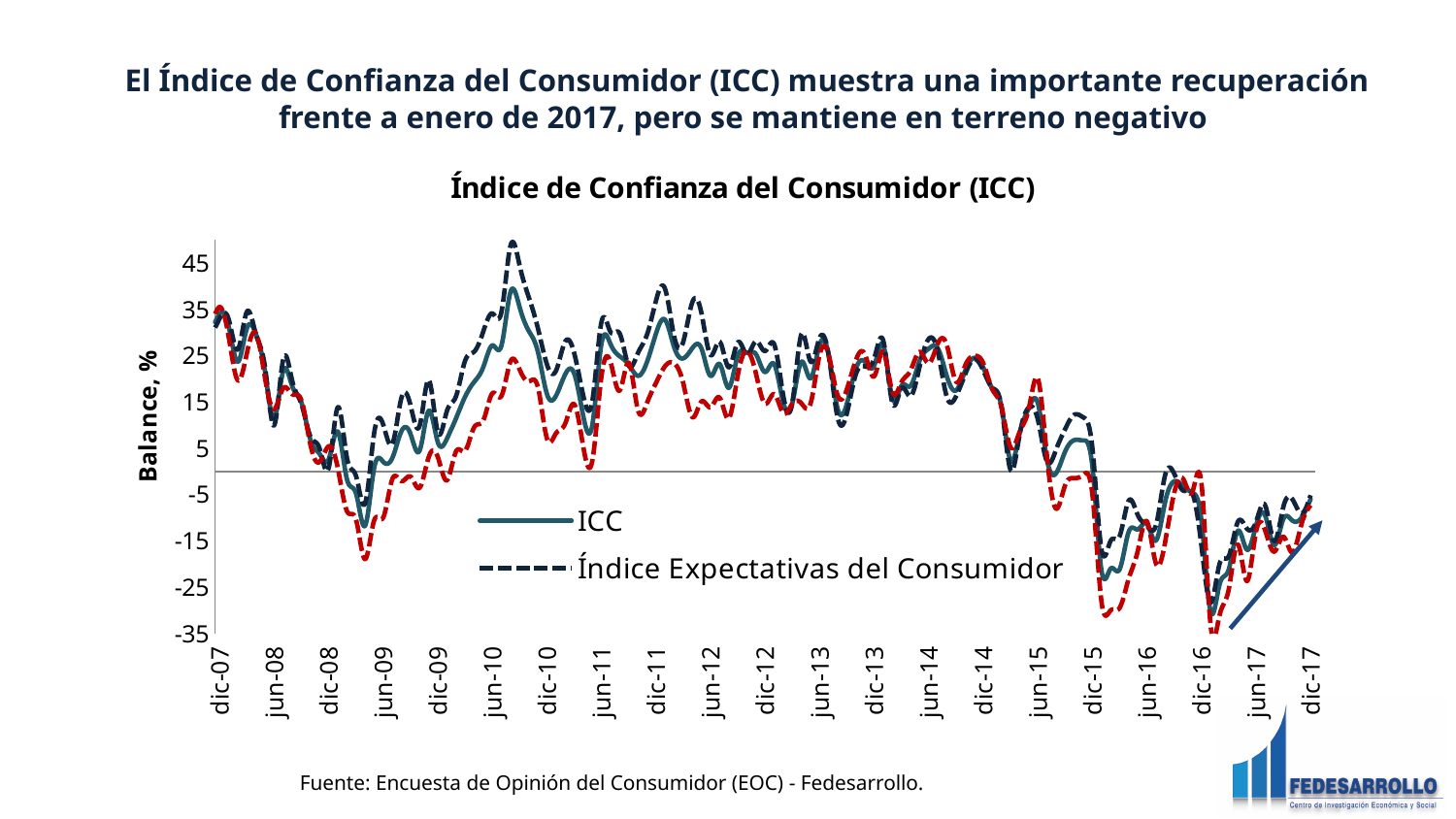
Around which x-axis date does the ICC series reach its lowest value? dic-16 What is the label on the vertical axis of the chart? Balance, % How many series does the chart legend list? 2 How many date labels are shown along the x axis? 21 Does the ICC series rise or fall between dic-16 and dic-17? rise Is the value of the ICC series at dic-17 greater or less than 5? less What is the title of the chart? Índice de Confianza del Consumidor (ICC) Around which x-axis date does the ICC series reach its highest value? jun-10 What kind of chart is shown on the slide? line chart